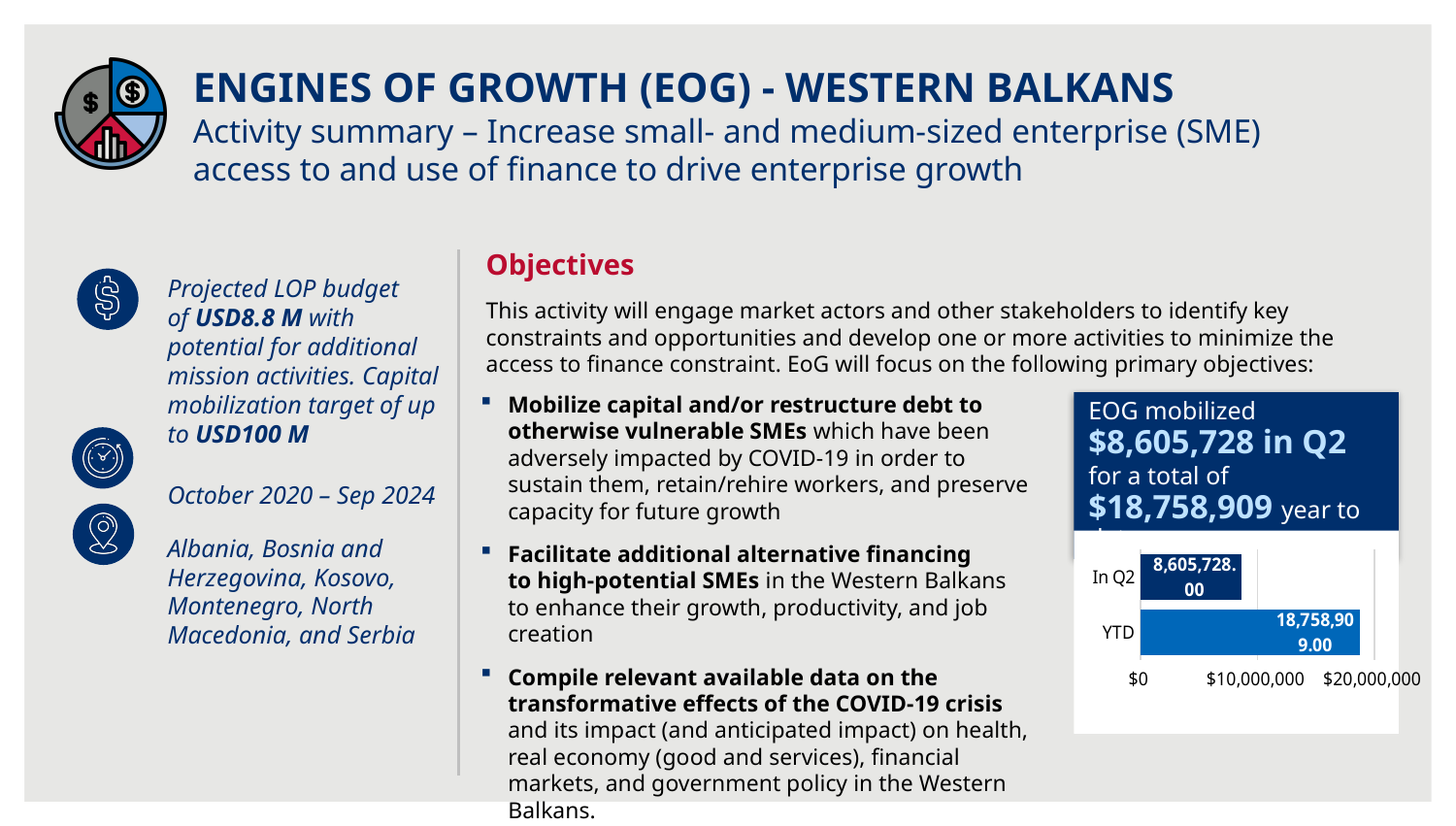
What is the highest tick value shown on the chart's horizontal axis? $20,000,000 What value is shown for the YTD bar? 18,758,909.00 Are the bars in the chart oriented horizontally or vertically? Horizontally What value is shown for the In Q2 bar? 8,605,728.00 What is the difference between the YTD value and the In Q2 value? 10,153,181.00 Which category has the higher value, In Q2 or YTD? YTD Is the value for YTD greater or less than $10,000,000? greater Is the value for In Q2 greater or less than $10,000,000? less Which category has the lower value in the chart? In Q2 Is the value for YTD greater or less than $20,000,000? less What kind of chart is shown on the slide? Bar chart How many categories are plotted in the chart? 2